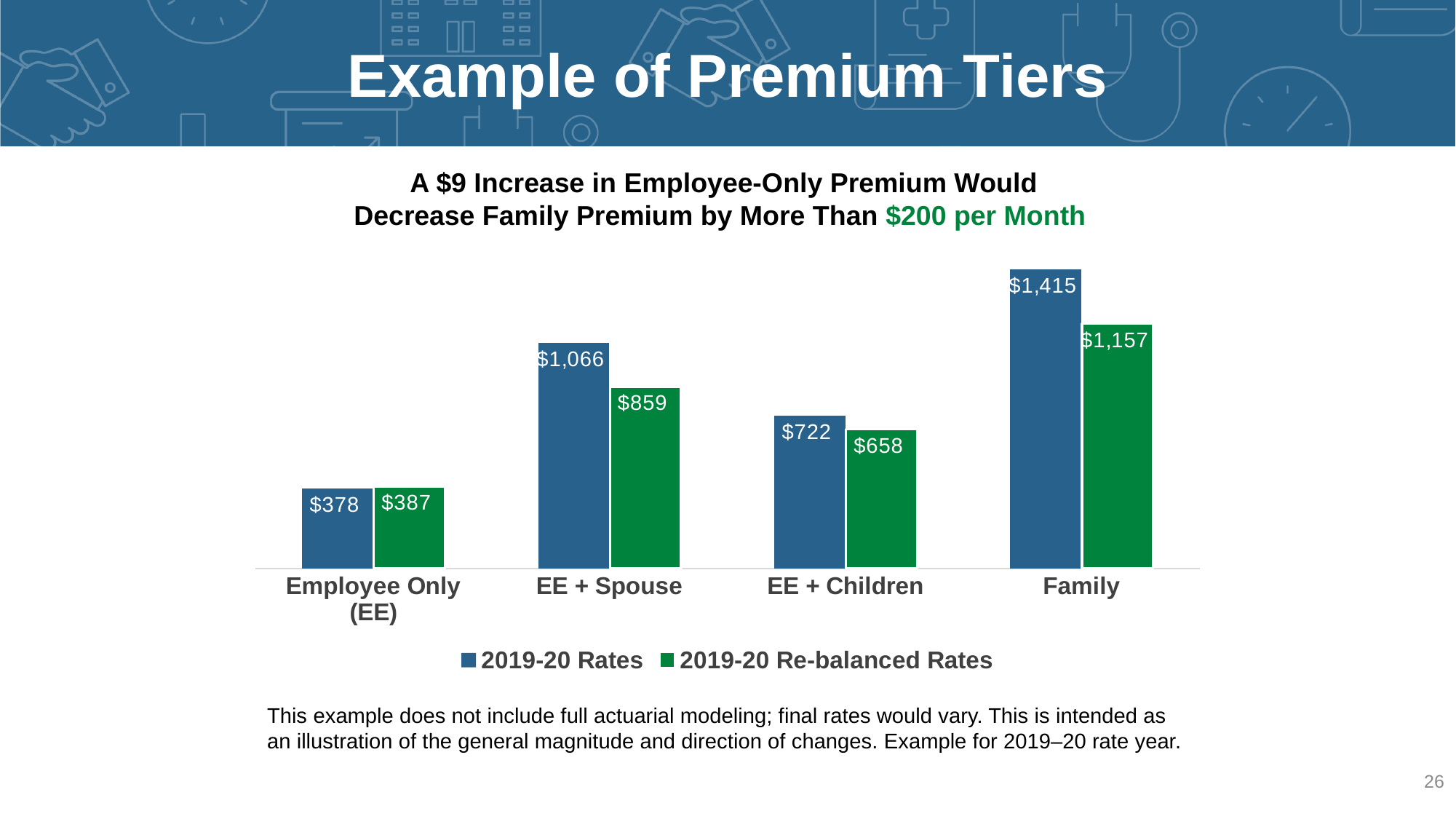
What is the 2019-20 Rates value for EE + Children? $722 Which category has the lowest 2019-20 Re-balanced Rates value? Employee Only (EE) How many series does the legend list? 2 What is the 2019-20 Rates value for Family? $1,415 Which category has the highest 2019-20 Rates value? Family What is the 2019-20 Re-balanced Rates value for Employee Only (EE)? $387 What is the difference between the 2019-20 Rates and the 2019-20 Re-balanced Rates for EE + Spouse? $207 What is the 2019-20 Re-balanced Rates value for EE + Spouse? $859 For Employee Only (EE), which is larger: the 2019-20 Rates value or the 2019-20 Re-balanced Rates value? 2019-20 Re-balanced Rates What kind of chart is shown on the slide? Bar chart How many categories are shown on the x axis? 4 What is the difference between the 2019-20 Rates and the 2019-20 Re-balanced Rates for Family? $258